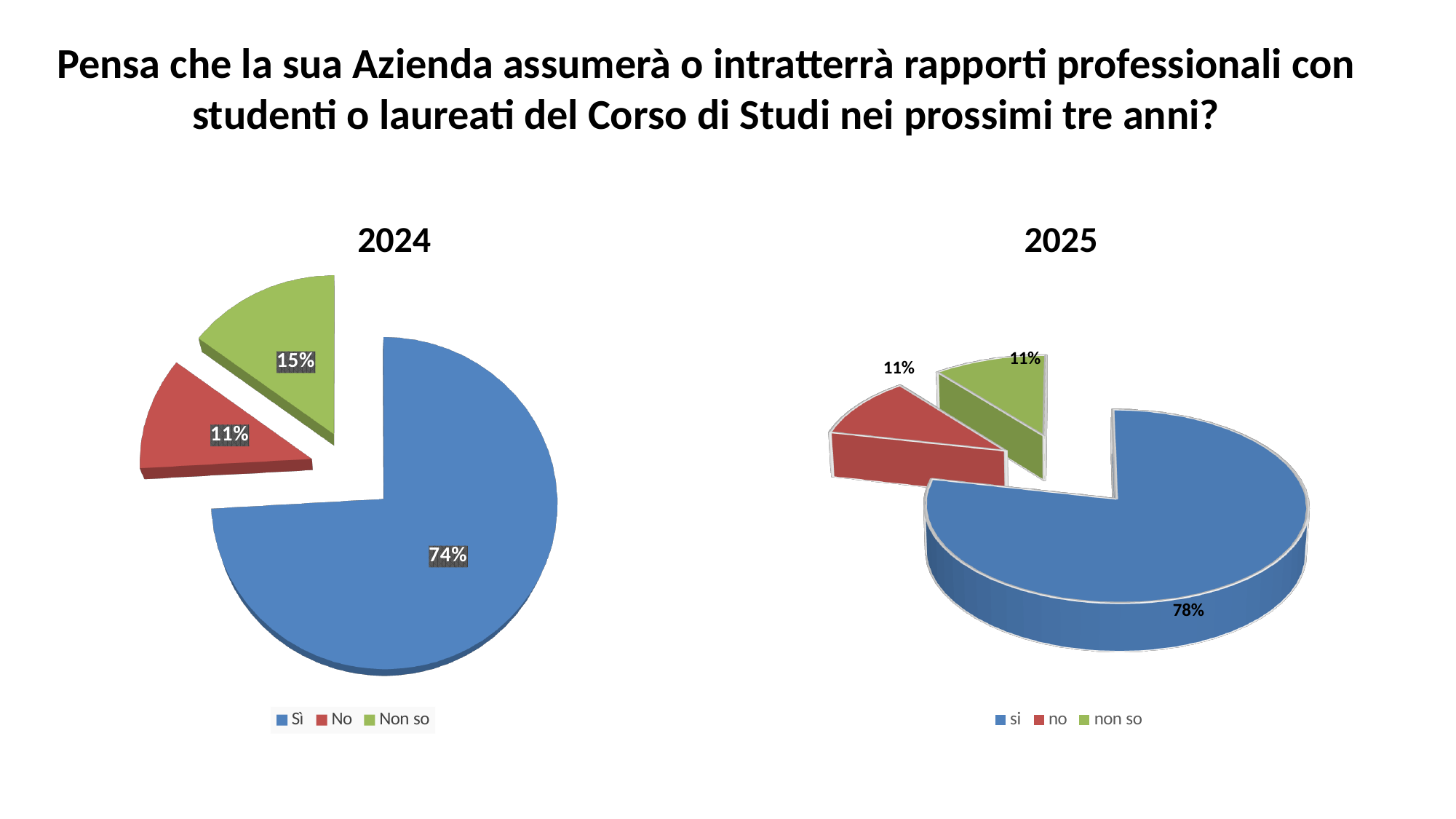
In the 2024 chart, which category has the largest slice? Sì In the 2025 chart, what percentage is shown for "si"? 78% In the 2024 chart, what percentage is shown for "Sì"? 74% How many slices does the 2025 chart have? 3 Is the "Sì" share in the 2024 chart larger or smaller than the "si" share in the 2025 chart? smaller In the 2024 chart, what percentage is shown for "Non so"? 15% What kind of chart is the 2024 chart? pie chart In the 2024 chart, which category has the smallest slice? No In the 2025 chart, what percentage is shown for "no"? 11% In the 2024 chart, what percentage is shown for "No"? 11% In the 2024 chart, what is the difference between the "Sì" and "Non so" percentages? 59 percentage points What colour is the "no" slice in the 2025 chart? red